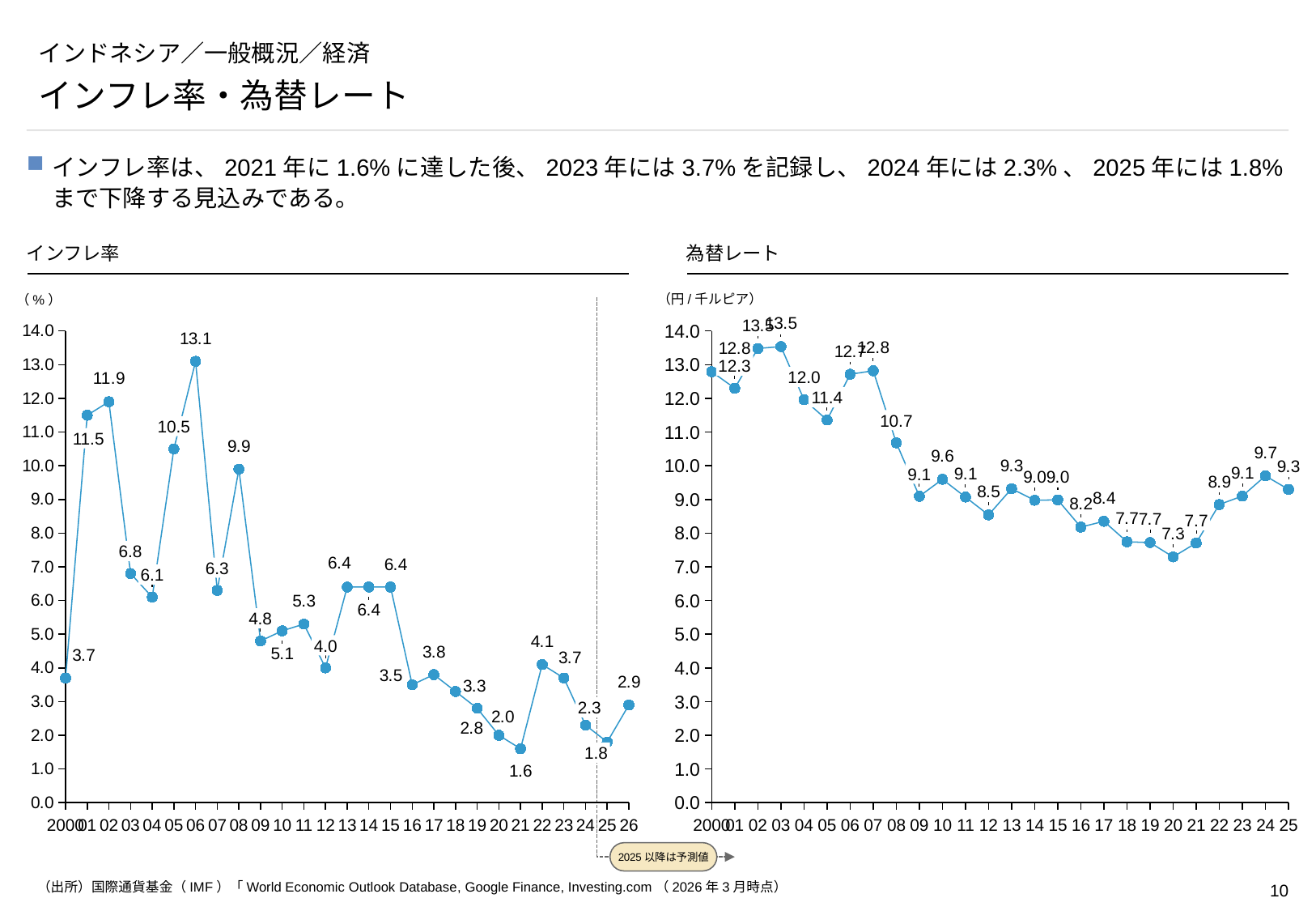
On the インフレ率 chart, which is larger, the value for 2002 or the value for 2005? 2002 On the 為替レート chart, what is the value for 2024? 9.7 On the インフレ率 chart, which year has the highest inflation rate? 2006 How many data points are plotted on the 為替レート chart? 26 On the インフレ率 chart, what is the inflation rate for 2006? 13.1 On the 為替レート chart, what is the value for 2020? 7.3 On the インフレ率 chart, what is the difference between the 2023 value and the 2024 value? 1.4 On the インフレ率 chart, what is the value for 2021? 1.6 On the 為替レート chart, what is the difference between the 2000 value and the 2008 value? 2.1 What kind of chart is the インフレ率 chart? Line chart On the インフレ率 chart, which year has the lowest inflation rate? 2021 On the 為替レート chart, which year has the lowest value? 2020